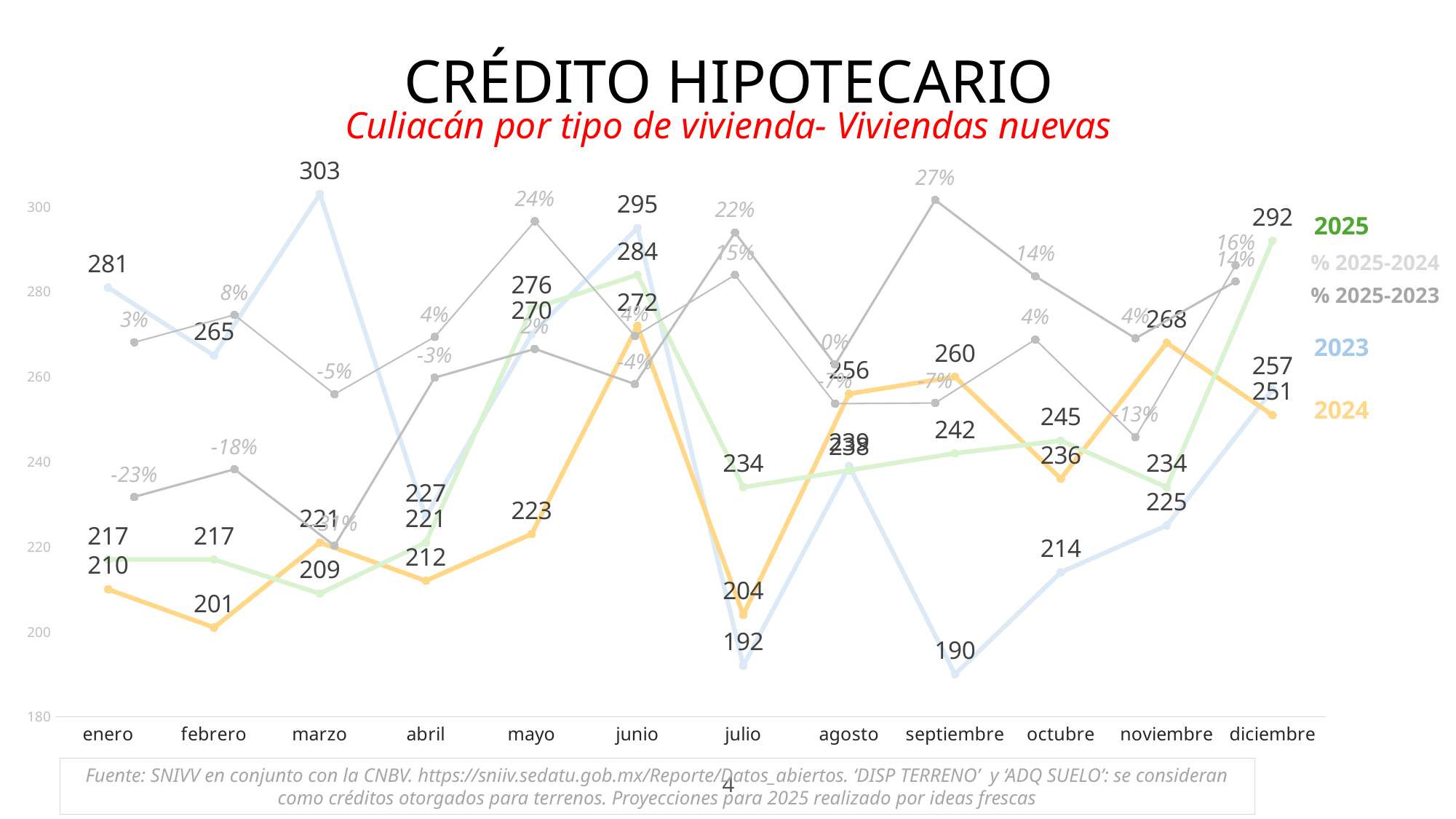
What is the value for 2024 in febrero? 201 What is the % 2025-2024 value for mayo? 24% What is the value for 2025 in diciembre? 292 What is the difference between the 2025 and 2024 values in diciembre? 41 What is the value for 2023 in marzo? 303 In which month does the 2023 series reach its lowest value? septiembre In which month does the 2023 series reach its highest value? marzo What kind of chart is shown on the slide? line chart How many series does the legend list? 5 In which month does the 2024 series have its lowest value? febrero How many months are shown on the x axis? 12 In julio, which is larger: the 2023 value or the 2024 value? 2024